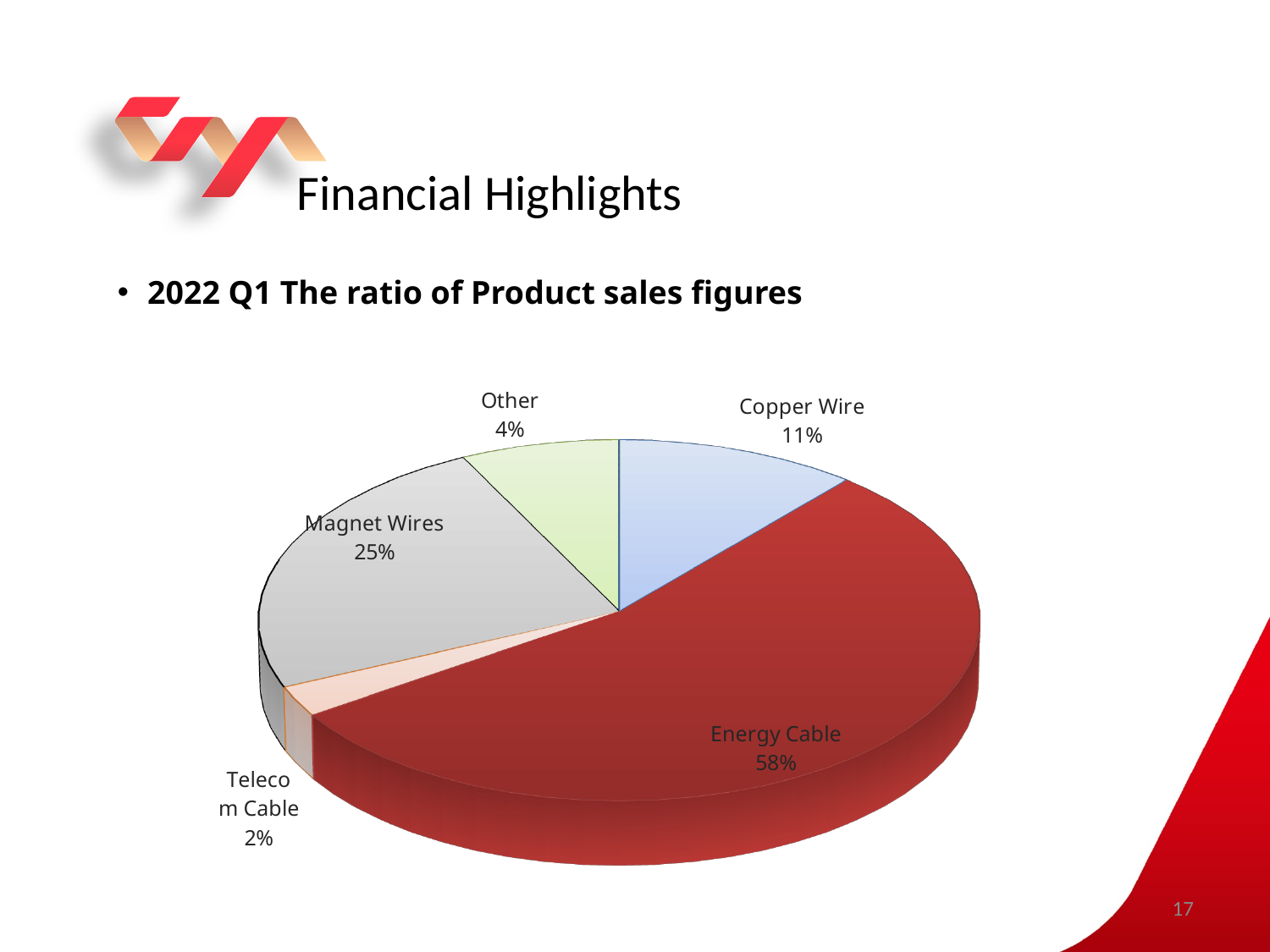
Which product category has the largest share of sales? Energy Cable What share of product sales does Telecom Cable account for? 2% Which has a larger share, Copper Wire or Other? Copper Wire Which product category has the smallest share of sales? Telecom Cable What share of product sales does Other account for? 4% What share of product sales does Magnet Wires account for? 25% What kind of chart is shown on the slide? Pie chart What share of product sales does Copper Wire account for? 11% How many product categories are shown in the pie chart? 5 What colour is the Energy Cable slice? Red What is the difference in percentage points between Energy Cable and Magnet Wires? 33 What share of product sales does Energy Cable account for? 58%